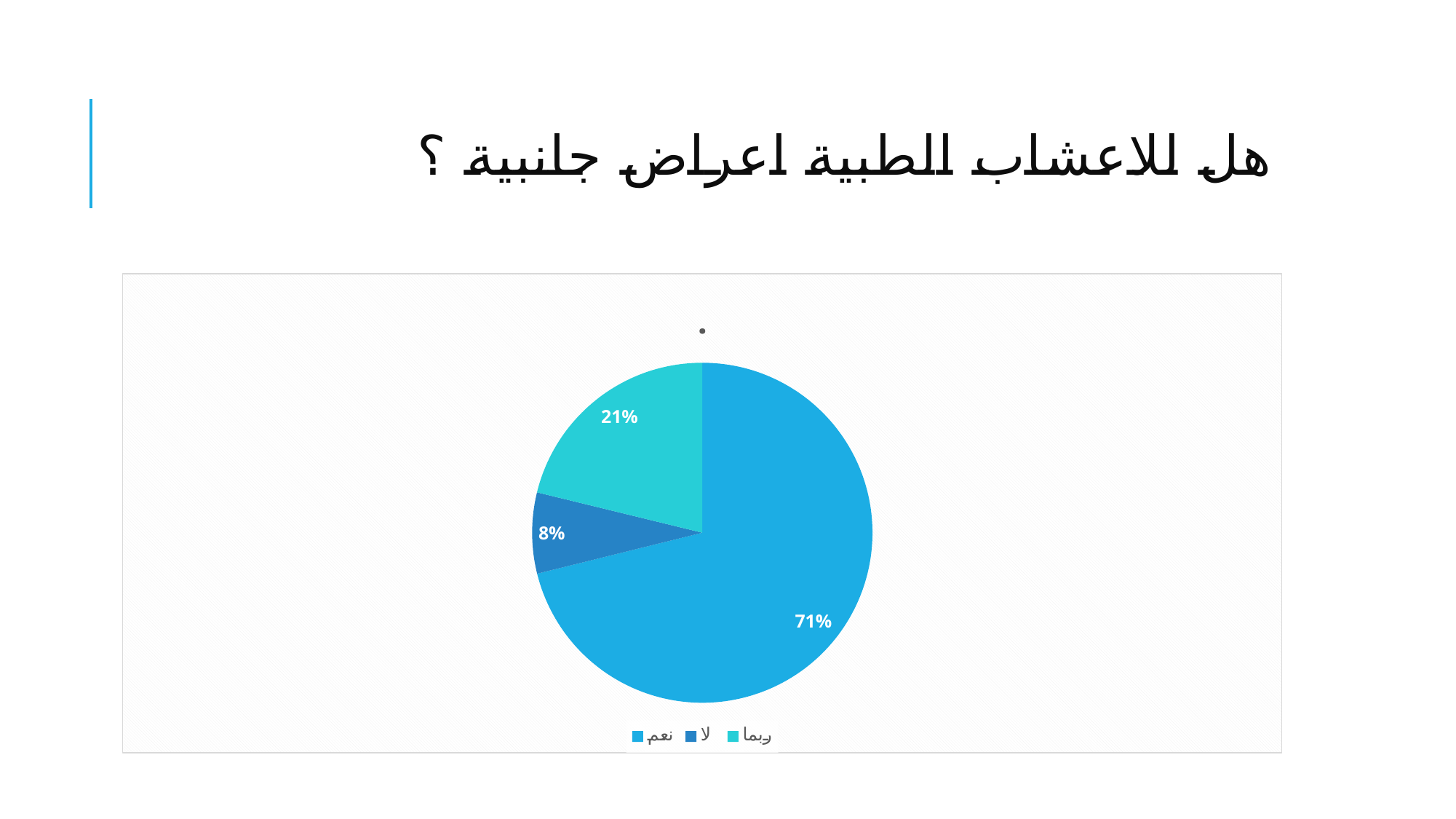
What percentage of the pie is the slice for نعم? 71% Which category has the smallest slice of the pie? لا What kind of chart is shown on the slide? Pie chart Which slice is larger, ربما or لا? ربما What is the title of the slide above the chart? هل للاعشاب الطبية اعراض جانبية ؟ How many entries does the legend list? 3 Which category has the largest slice of the pie? نعم How many slices does the pie chart have? 3 What is the difference in percentage points between the ربما slice and the لا slice? 13 What percentage of the pie is the slice for ربما? 21% What percentage of the pie is the slice for لا? 8% What is the difference in percentage points between the نعم slice and the ربما slice? 50